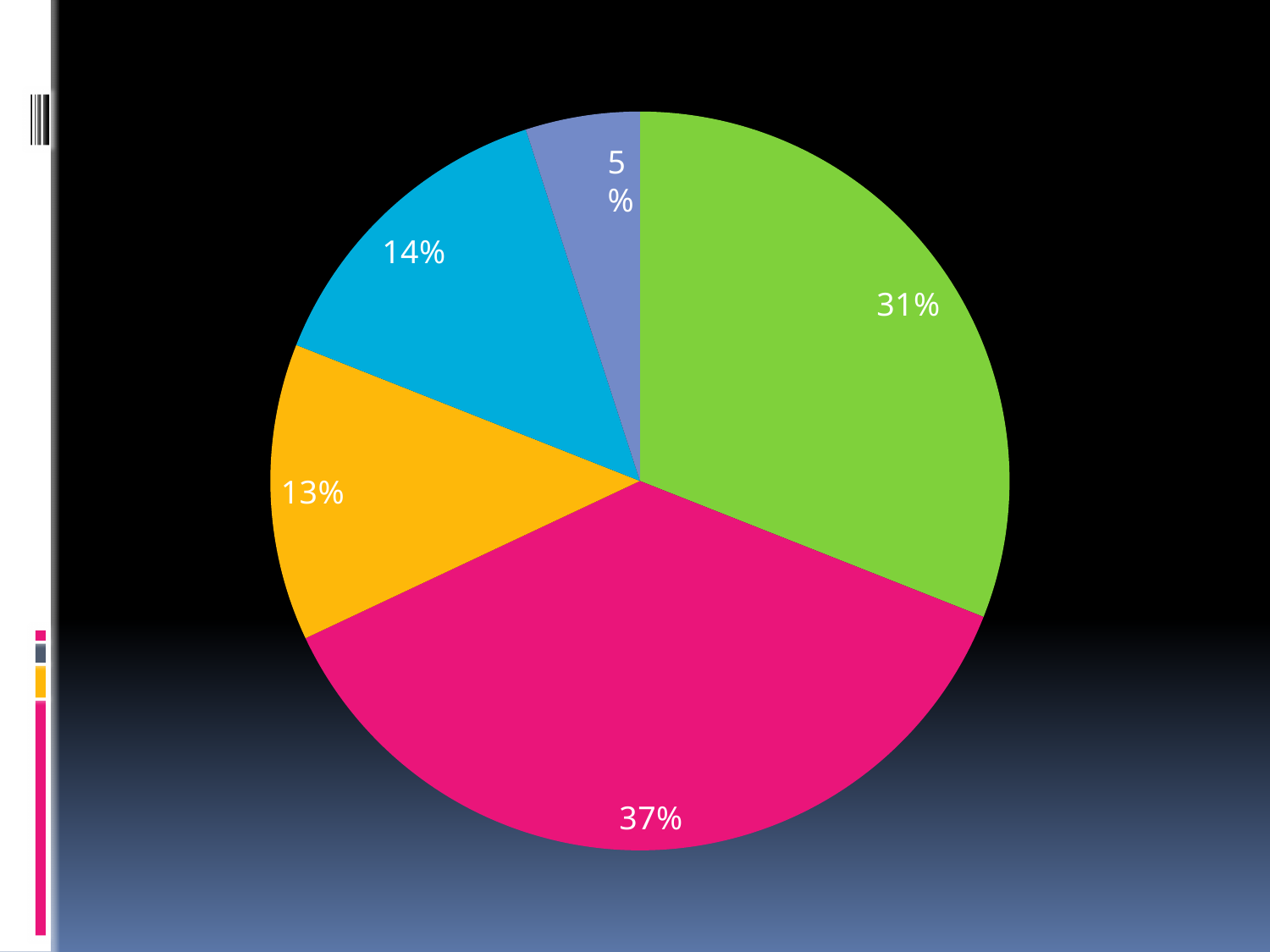
Which slice is larger, the light blue slice or the orange slice? the light blue slice How many slices does the pie chart have? 5 What is the difference in percentage points between the magenta slice and the green slice? 6 What kind of chart is shown on the slide? pie chart What is the difference in percentage points between the green slice and the purple-blue slice? 26 What percentage is shown on the light blue slice of the pie chart? 14% What colour is the largest slice of the pie chart? magenta What percentage is shown on the orange slice of the pie chart? 13% What percentage is shown on the green slice of the pie chart? 31% What percentage is shown on the smallest slice of the pie chart? 5% What is the combined percentage of the magenta and green slices? 68% What percentage is shown on the largest slice of the pie chart? 37%